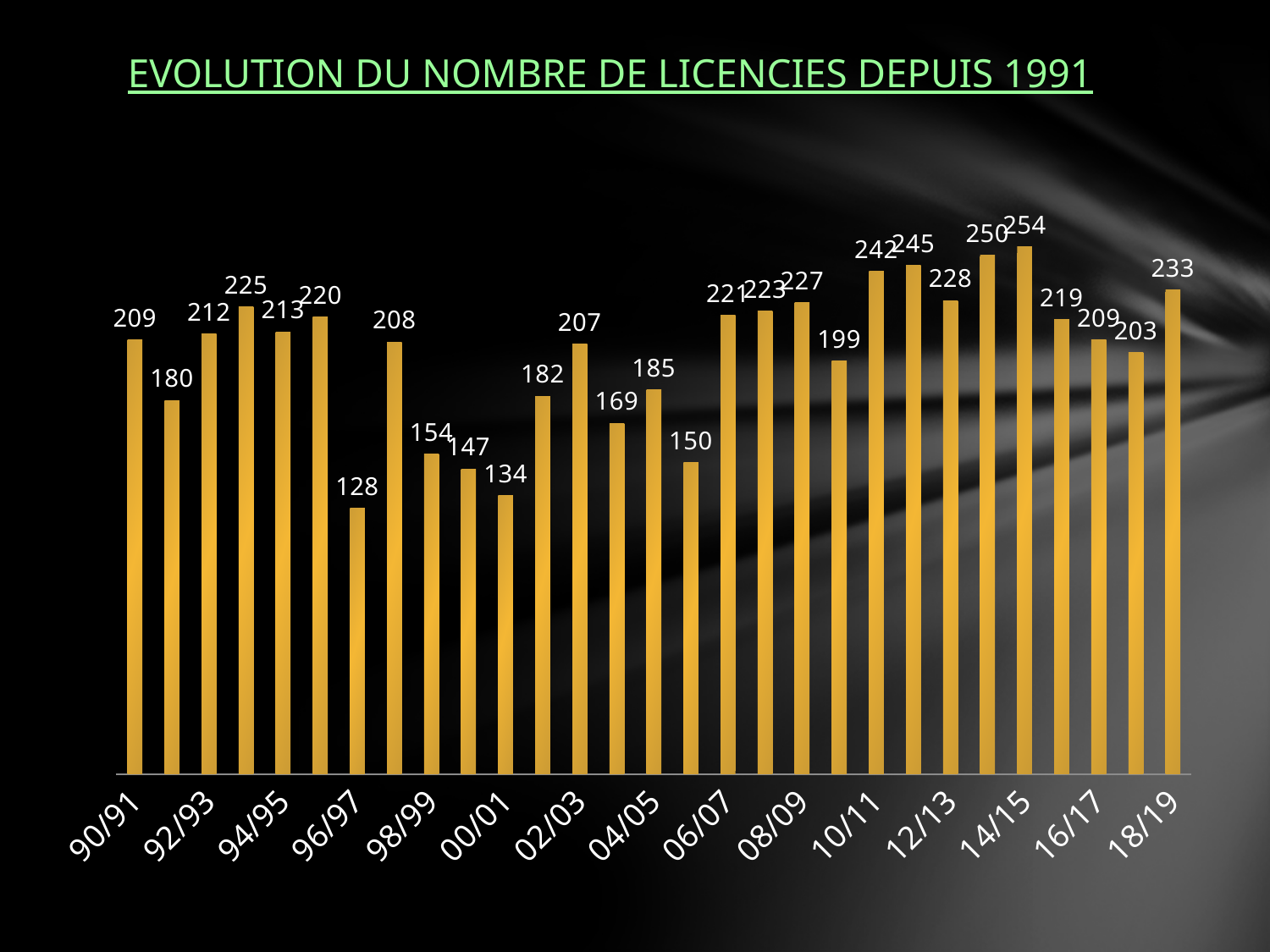
How many bars are plotted in the chart? 29 What is the difference between the values for 18/19 and 16/17? 24 What is the value for 96/97? 128 Which season has the highest value? 14/15 What is the value for 14/15? 254 Which season has the lowest value? 96/97 What is the title of the chart? EVOLUTION DU NOMBRE DE LICENCIES DEPUIS 1991 Which is larger, the value for 10/11 or the value for 12/13? 10/11 What is the value for 18/19? 233 What is the difference between the values for 14/15 and 96/97? 126 What is the value for 90/91? 209 What kind of chart is shown on the slide? bar chart